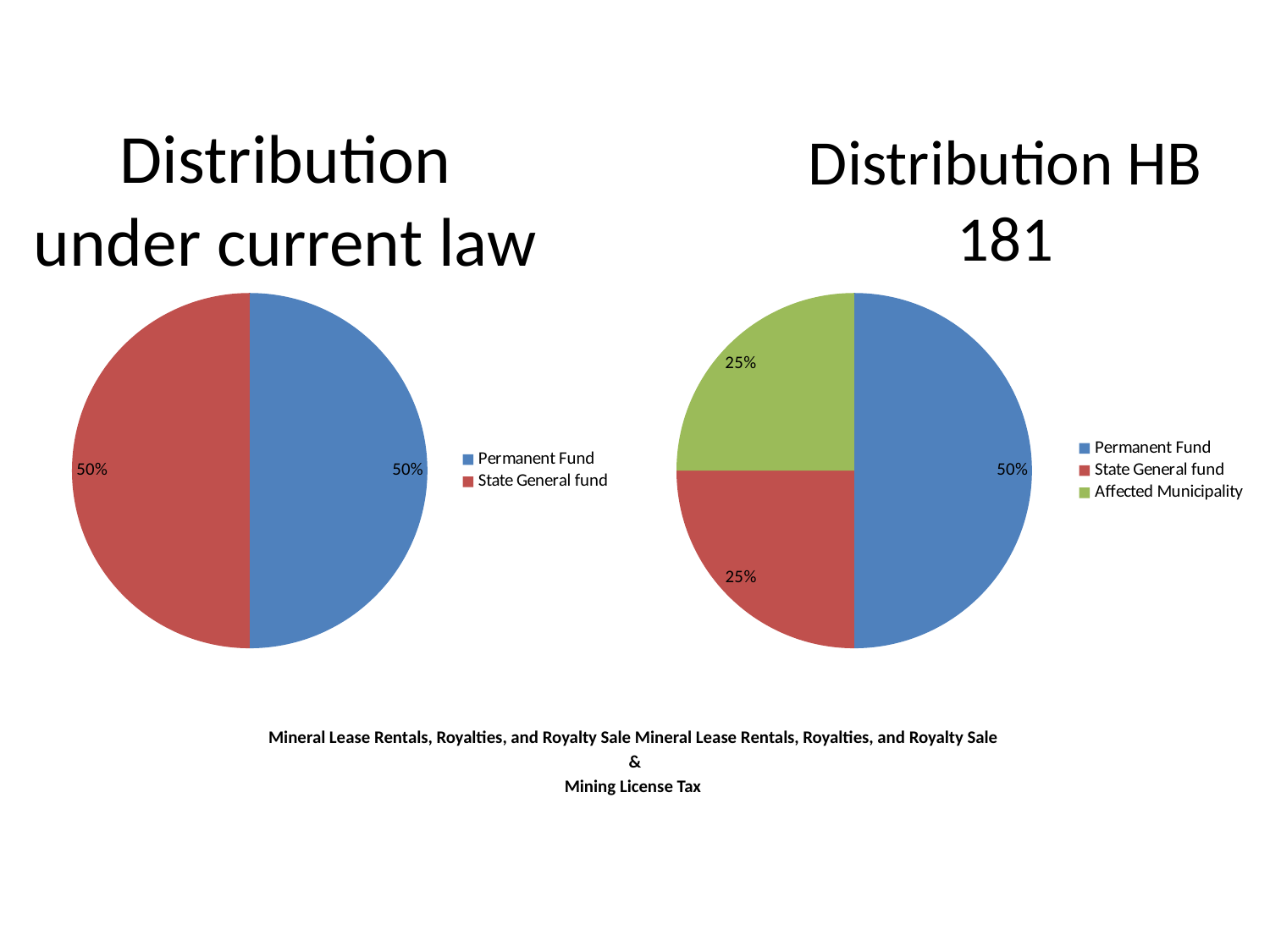
In the 'Distribution HB 181' chart, what share goes to the State General fund? 25% In the 'Distribution under current law' chart, what share goes to the State General fund? 50% How many categories does the legend of the 'Distribution under current law' chart list? 2 In the 'Distribution HB 181' chart, what share goes to the Affected Municipality? 25% In the 'Distribution HB 181' chart, what colour is the Affected Municipality slice? Green In the 'Distribution HB 181' chart, what is the difference between the Permanent Fund share and the State General fund share? 25% How many slices does the 'Distribution HB 181' chart have? 3 In the 'Distribution HB 181' chart, which category has the largest slice? Permanent Fund What type of chart is the 'Distribution under current law' chart? Pie chart In the 'Distribution HB 181' chart, which is larger: the Permanent Fund slice or the Affected Municipality slice? Permanent Fund